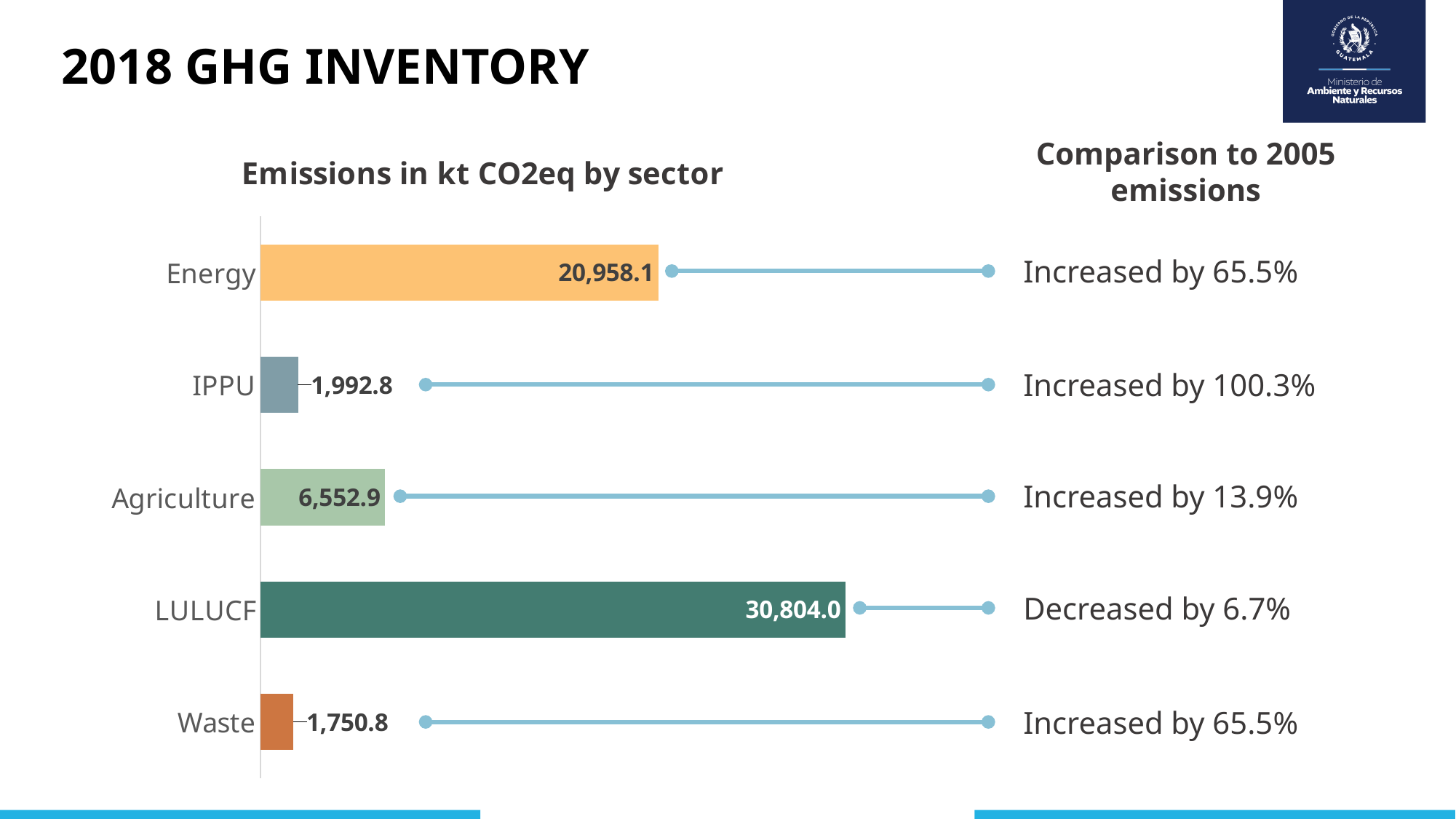
How many sectors are shown in the chart? 5 What is the emissions value for Waste? 1,750.8 What type of chart is shown on the slide? Bar chart What is the emissions value for Energy in the chart? 20,958.1 What is the emissions value for LULUCF? 30,804.0 What is the difference in emissions between LULUCF and Energy? 9,845.9 What is the emissions value for Agriculture? 6,552.9 Which sector has the highest emissions in the chart? LULUCF Which sector has higher emissions, Agriculture or IPPU? Agriculture What is the title of the chart? Emissions in kt CO2eq by sector Which sector has the lowest emissions in the chart? Waste What is the difference in emissions between IPPU and Waste? 242.0